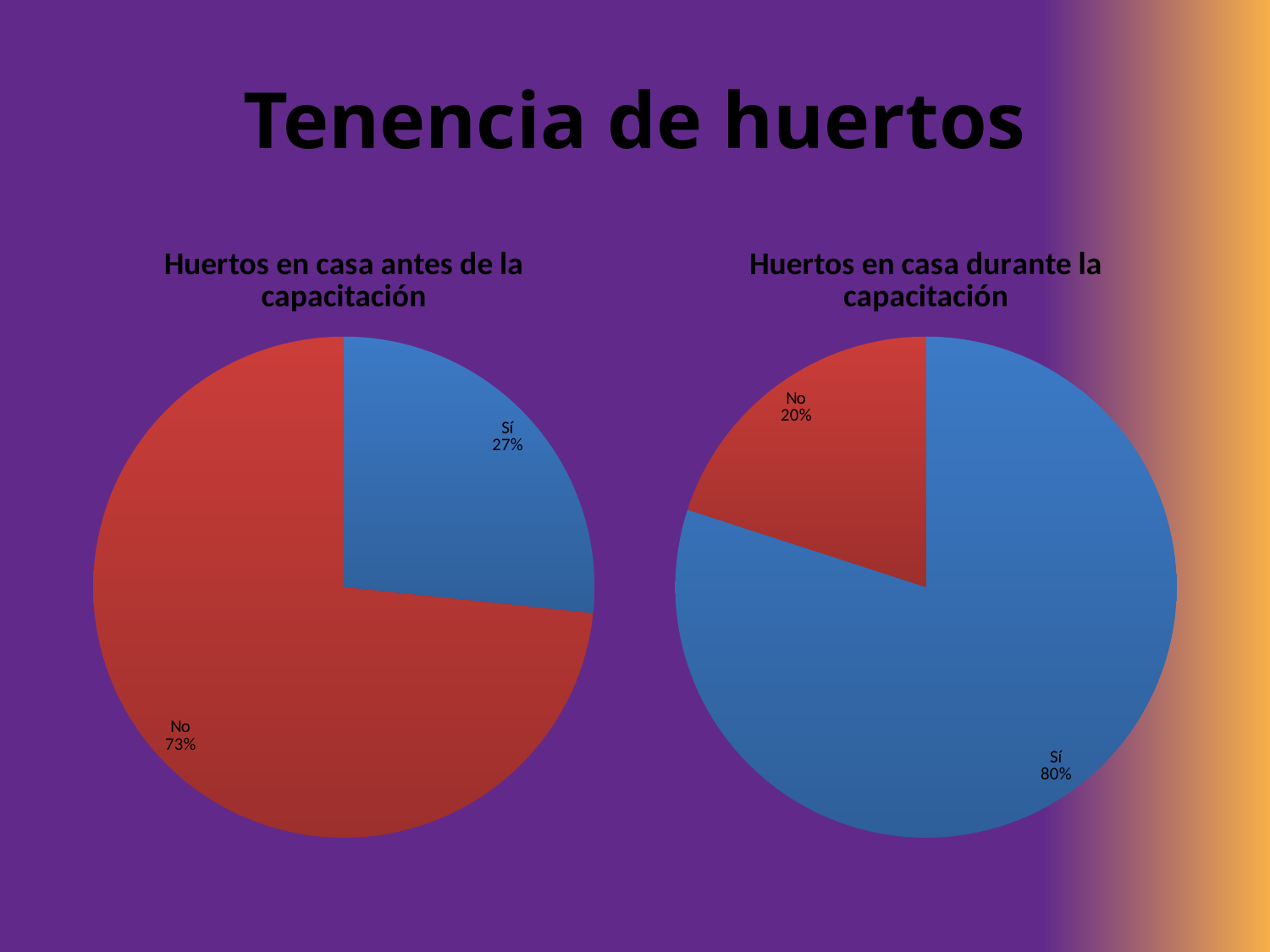
In the chart 'Huertos en casa durante la capacitación', what share of the pie is 'Sí'? 80% Which is larger: the 'Sí' share in the left chart or the 'Sí' share in the right chart? The right chart (80%) How many slices does the chart 'Huertos en casa antes de la capacitación' have? 2 In the chart 'Huertos en casa antes de la capacitación', what is the difference between the 'No' and 'Sí' shares? 46% In the chart 'Huertos en casa durante la capacitación', what share of the pie is 'No'? 20% What kind of chart is 'Huertos en casa durante la capacitación'? Pie chart In the chart 'Huertos en casa durante la capacitación', which slice is the smallest? No In the chart 'Huertos en casa durante la capacitación', what is the difference between the 'Sí' and 'No' shares? 60% In the chart 'Huertos en casa antes de la capacitación', what share of the pie is 'No'? 73% What is the title of the chart on the right side of the slide? Huertos en casa durante la capacitación In the chart 'Huertos en casa antes de la capacitación', which slice is the largest? No